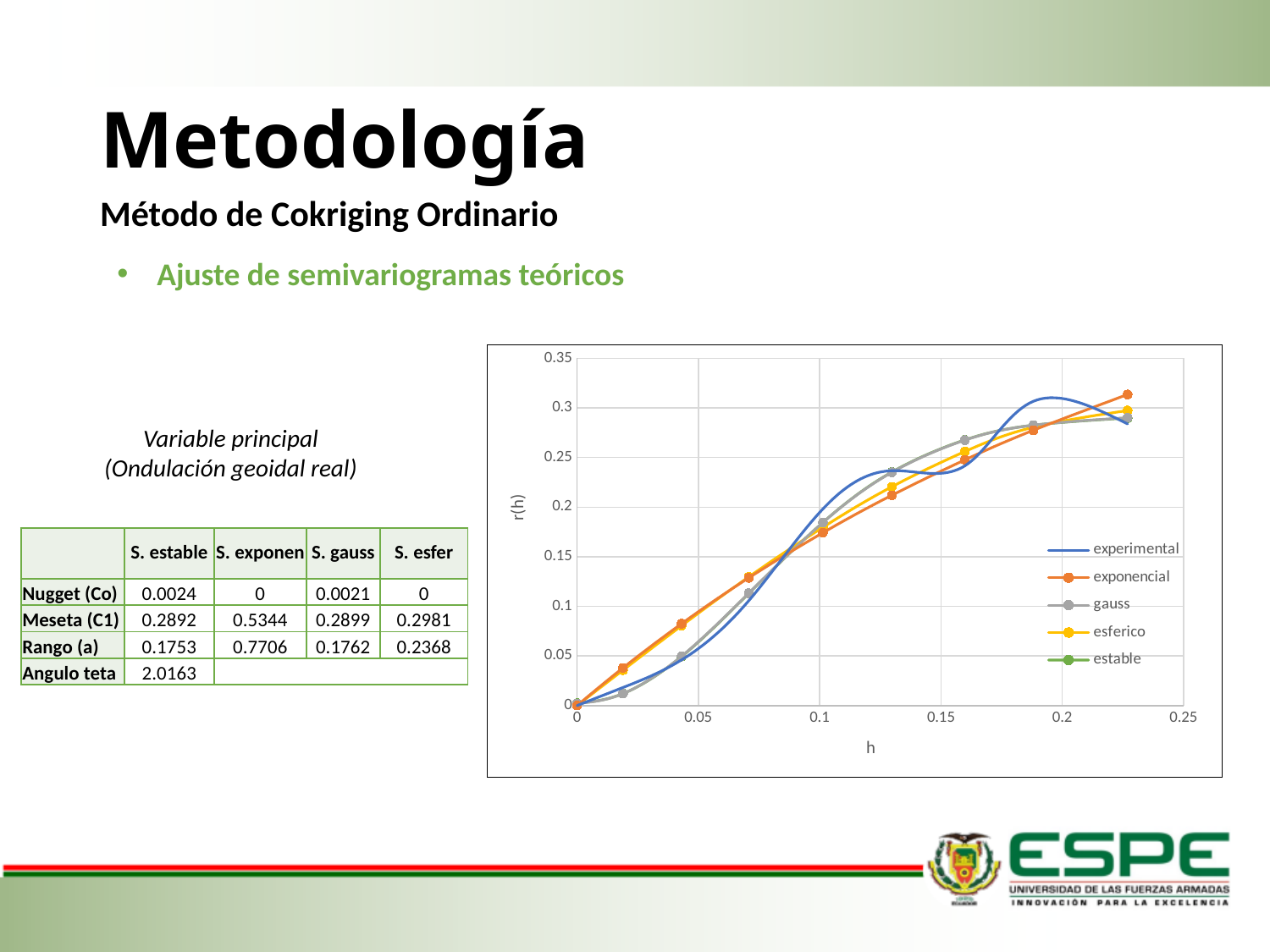
Do the values of the exponencial series rise or fall as h increases? Rise At the largest h value plotted, which series has the highest r(h)? exponencial What kind of chart is shown on the slide? Line chart What is the label of the y axis of the chart? r(h) At h = 0.05, which series has the larger value, exponencial or gauss? exponencial Is the value of the gauss series at its last point (h about 0.225) greater or less than 0.3? less What is the label of the x axis of the chart? h Is the value of the exponencial series at its last point (h about 0.225) greater or less than 0.3? greater How many data points are marked on the exponencial series? 9 Is the value of the exponencial series at h = 0.1 greater or less than 0.2? less How many series does the chart legend list? 5